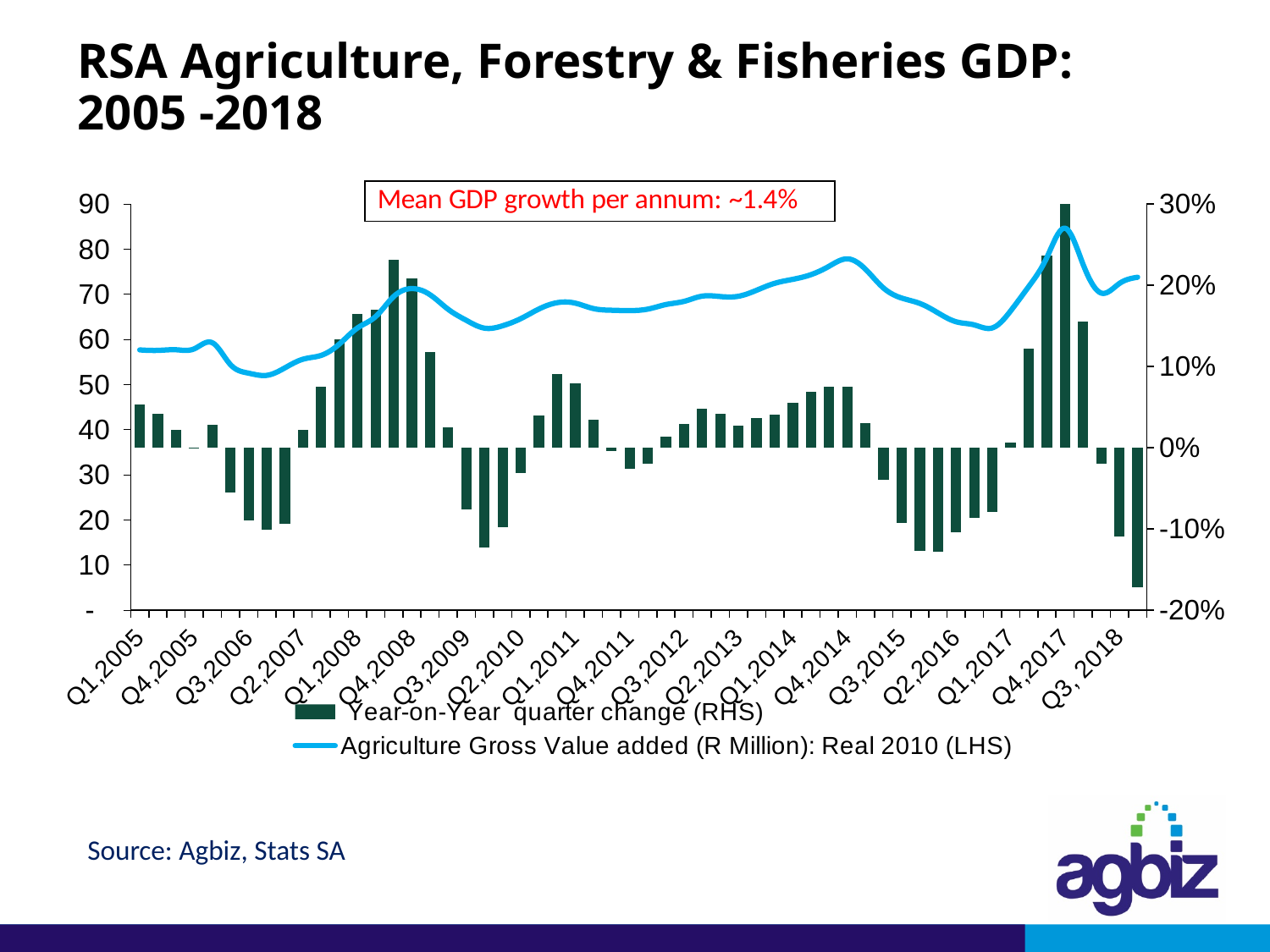
Is the Agriculture Gross Value added line for Q1,2005 greater or less than 50? greater Is the Agriculture Gross Value added line for Q4,2014 greater or less than 70? greater Is the Year-on-Year quarter change for Q2,2016 greater or less than 0%? less How many series does the legend list? 2 What kind of chart is shown on the slide? A combination bar and line chart In which quarter is the Year-on-Year quarter change bar the highest? Q4,2017 What mean GDP growth per annum is stated in the annotation box on the chart? ~1.4% Does the Agriculture Gross Value added line overall rise or fall from Q1,2005 to Q3,2018? rise What is the title of the chart? RSA Agriculture, Forestry & Fisheries GDP: 2005 -2018